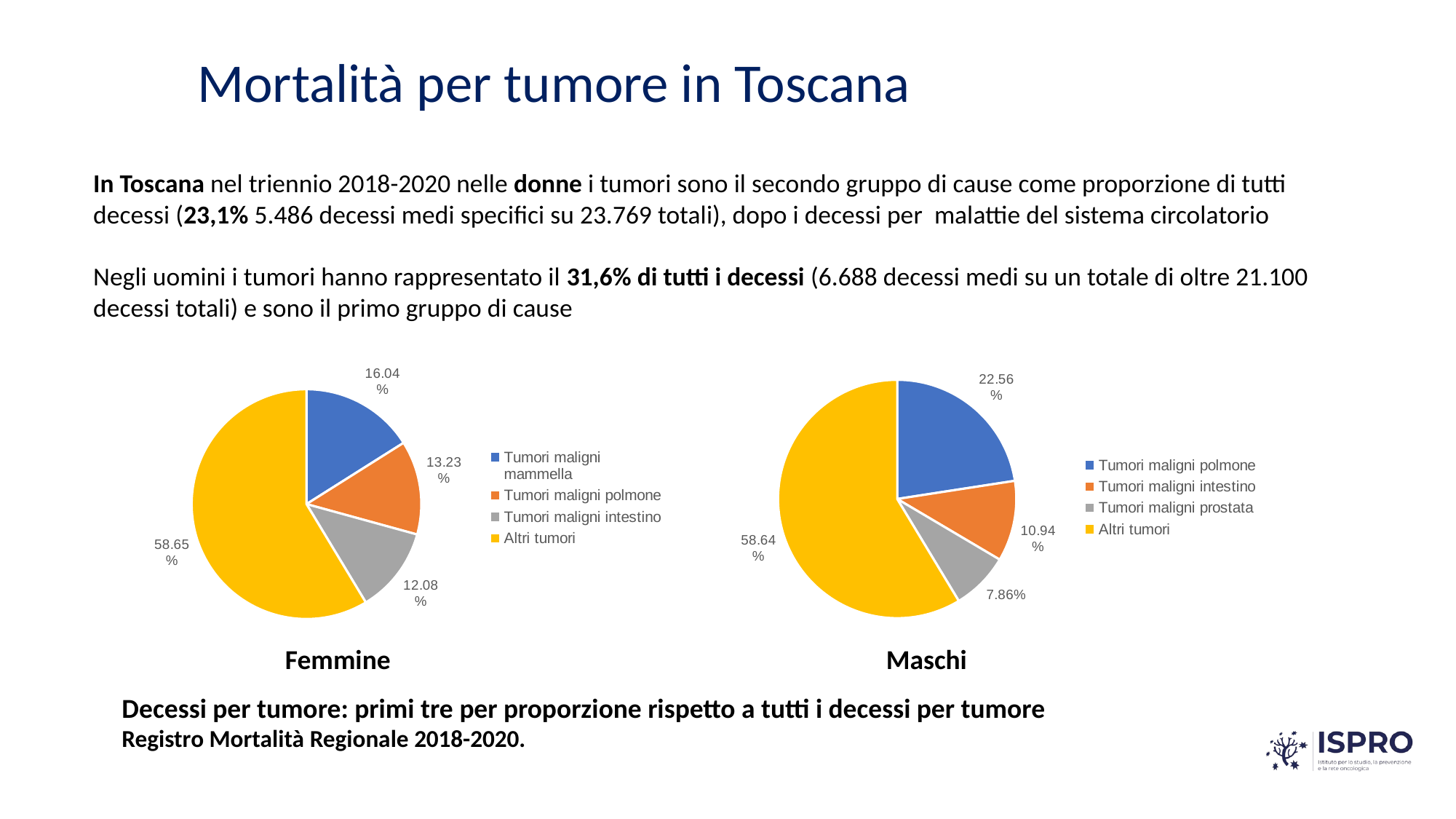
In the Femmine pie chart, what colour is the Altri tumori slice? Yellow In the Femmine pie chart, which category has the largest slice? Altri tumori In the Maschi pie chart, what is the share for Tumori maligni polmone? 22.56% In the Maschi pie chart, what is the difference between the shares for Tumori maligni polmone and Tumori maligni intestino? 11.62% In the Femmine pie chart, what is the share for Tumori maligni intestino? 12.08% What type of chart is used for Femmine? Pie chart Which is larger: the share for Tumori maligni polmone in the Femmine chart or in the Maschi chart? Maschi In the Maschi pie chart, what is the share for Tumori maligni prostata? 7.86% In the Femmine pie chart, what is the difference between the shares for Tumori maligni mammella and Tumori maligni polmone? 2.81% In the Maschi pie chart, which category has the smallest slice? Tumori maligni prostata How many slices does the Maschi pie chart have? 4 In the Femmine pie chart, what is the share for Tumori maligni mammella? 16.04%